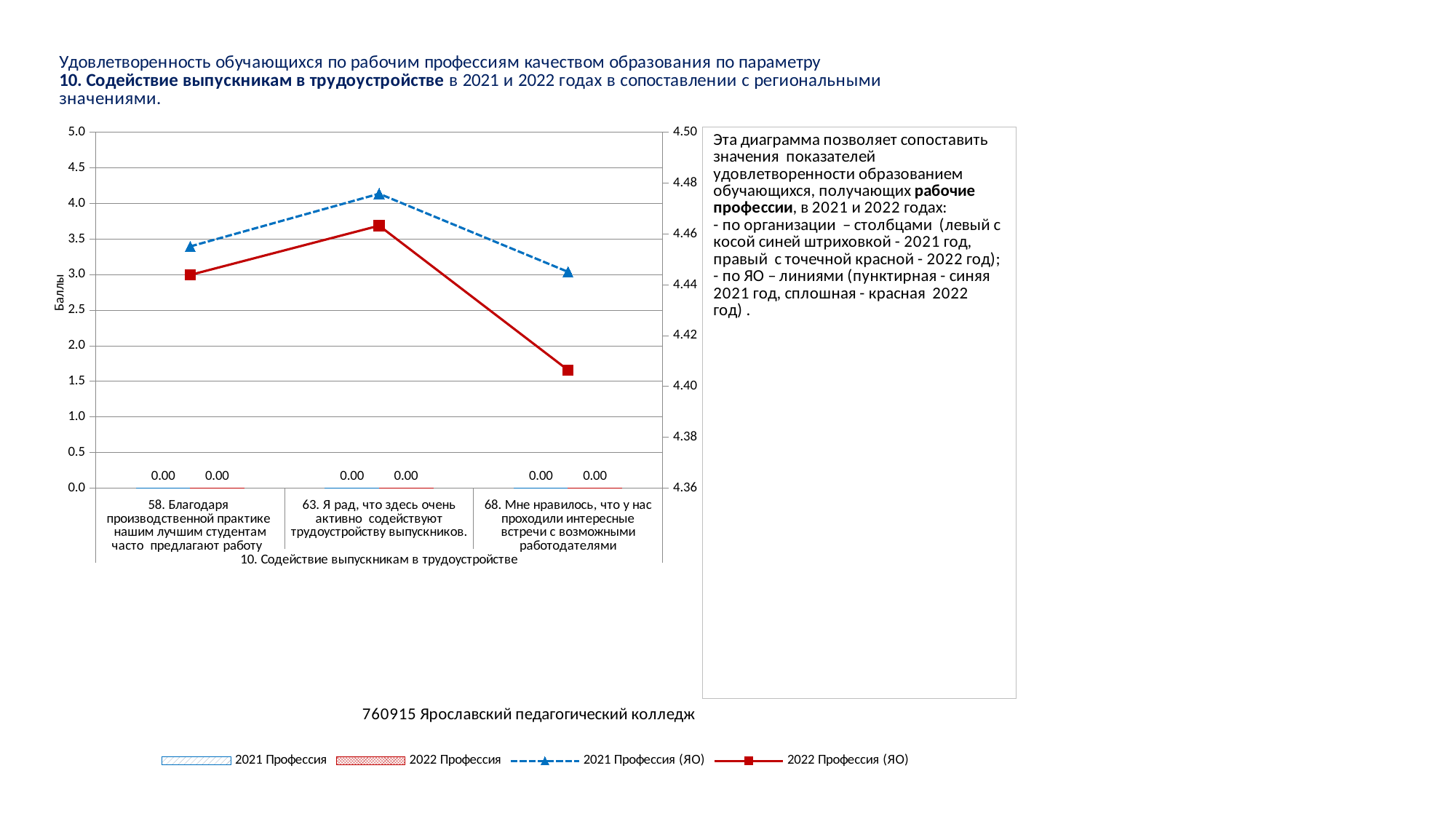
For category 68, which line is higher: 2021 Профессия (ЯО) or 2022 Профессия (ЯО)? 2021 Профессия (ЯО) Is the 2022 Профессия (ЯО) value for category 68 greater or less than 4.42 on the right axis? less What is the value of the 2021 Профессия bar for category 58 (Благодаря производственной практике нашим лучшим студентам часто предлагают работу)? 0.00 For which category does the 2022 Профессия (ЯО) line have its lowest value? 68. Мне нравилось, что у нас проходили интересные встречи с возможными работодателями How many series does the chart legend list? 4 Is the 2021 Профессия (ЯО) value for category 63 greater or less than 4.46 on the right axis? greater Does the 2022 Профессия (ЯО) line rise or fall from category 63 to category 68? falls How many categories are shown on the x axis of the chart? 3 What is the value of the 2022 Профессия bar for category 63 (Я рад, что здесь очень активно содействуют трудоустройству выпускников)? 0.00 What kind of chart is shown on the slide? Combined bar and line chart For which category does the 2021 Профессия (ЯО) line reach its highest value? 63. Я рад, что здесь очень активно содействуют трудоустройству выпускников. What is the label of the left vertical axis of the chart? Баллы